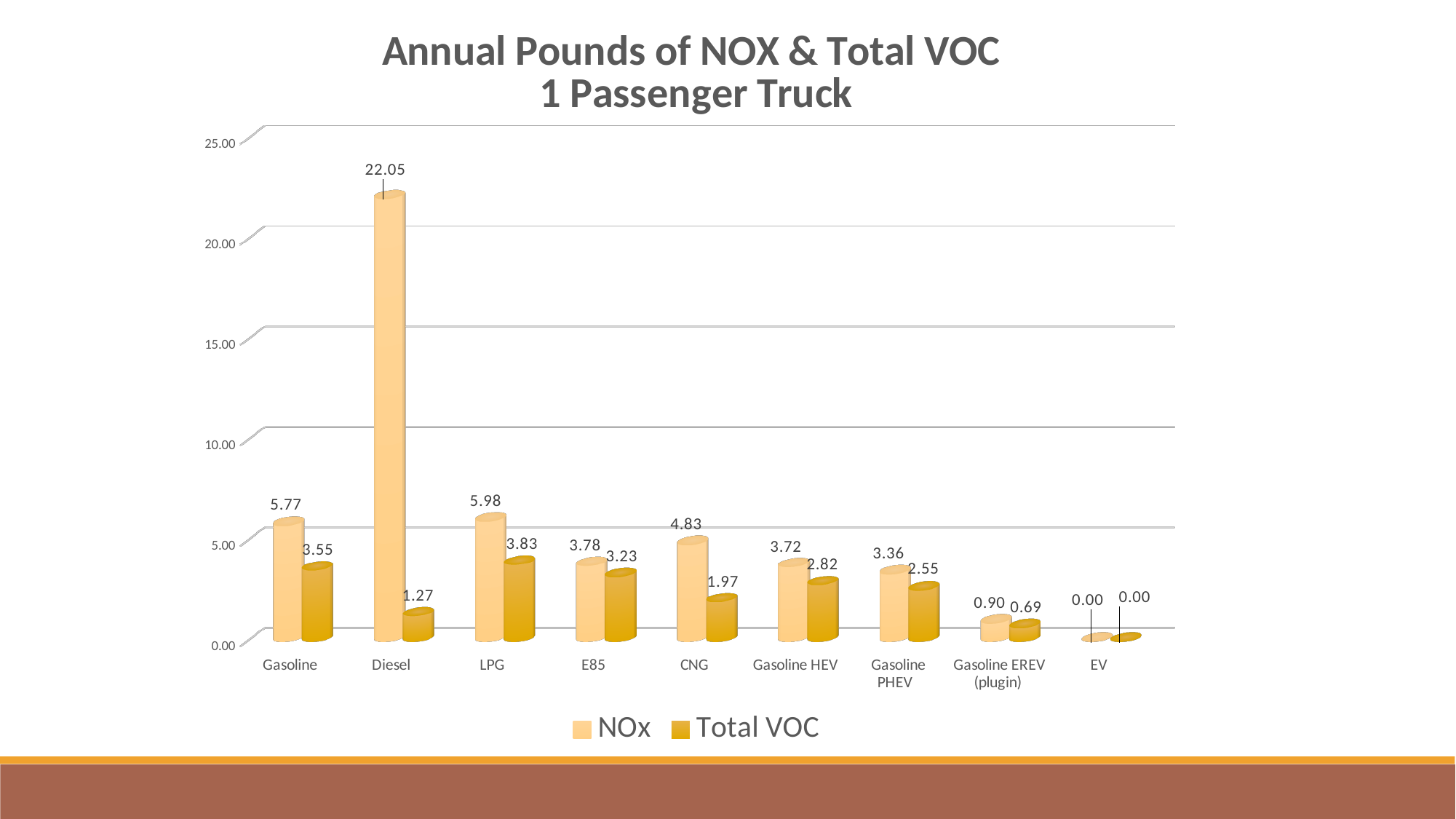
How many categories are shown on the x axis? 9 Which category has the highest NOx value? Diesel What is the NOx value for Gasoline EREV (plugin)? 0.90 How many series does the legend list? 2 Is the NOx value for Diesel greater or less than 20.00? greater What is the Total VOC value for LPG? 3.83 What is the difference between the NOx and Total VOC values for Gasoline? 2.22 What kind of chart is shown on the slide? bar chart What is the NOx value for Diesel? 22.05 Which is larger, the NOx value for LPG or the NOx value for CNG? LPG What is the title of the chart? Annual Pounds of NOX & Total VOC 1 Passenger Truck Which category has the lowest Total VOC value? EV